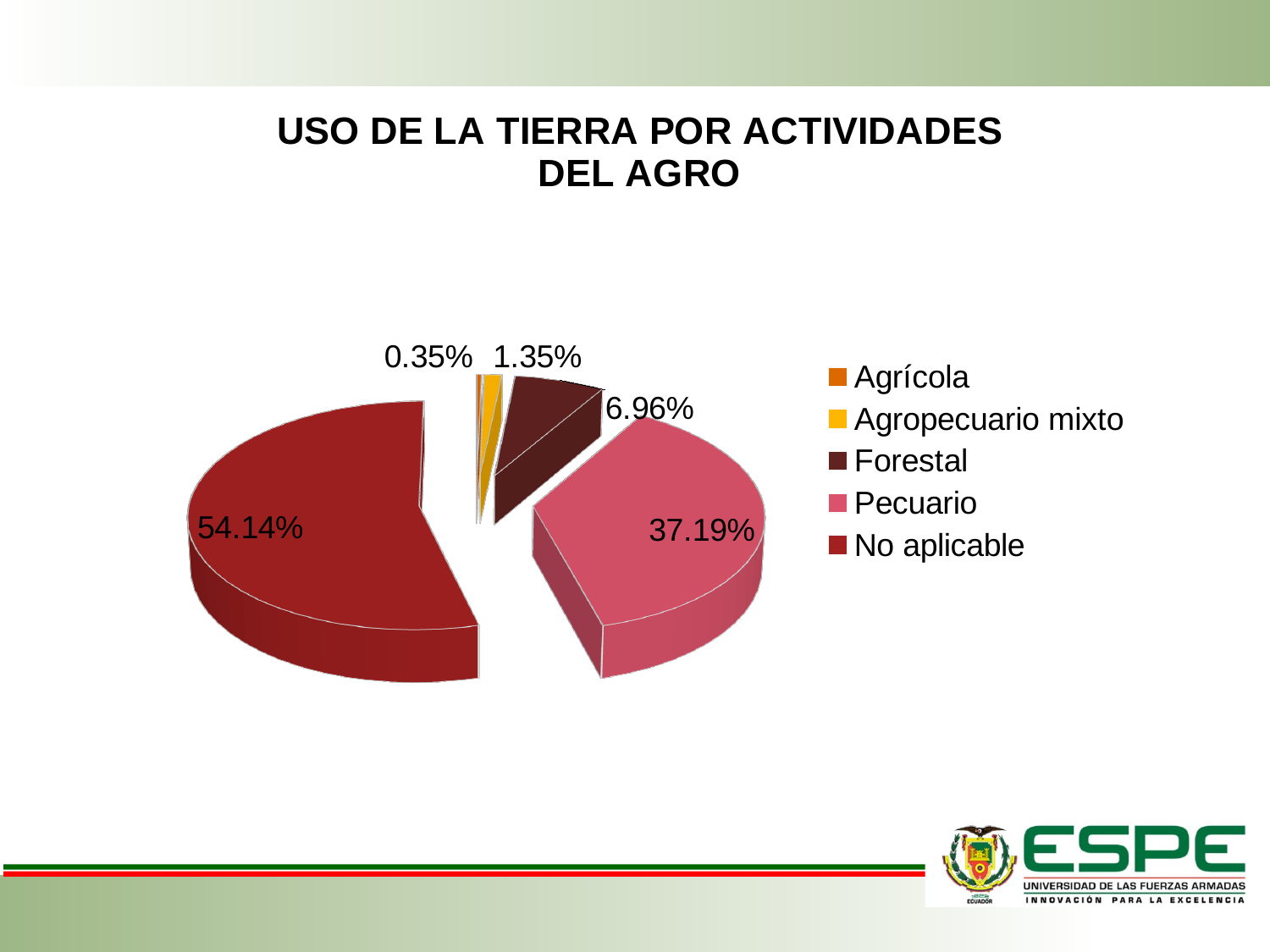
Which legend entry is shown in pink? Pecuario What is the difference between the No aplicable and Pecuario shares? 16.95% What share of the pie does No aplicable represent? 54.14% What kind of chart is shown on the slide? Pie chart What is the title of the chart? USO DE LA TIERRA POR ACTIVIDADES DEL AGRO How many categories does the legend list? 5 Which category has the largest slice of the pie? No aplicable What is the value shown for Agropecuario mixto? 1.35% Which is larger, the Forestal share or the Pecuario share? Pecuario Which category has the smallest slice of the pie? Agrícola What is the value shown for Forestal? 6.96% What share of the pie does Pecuario represent? 37.19%